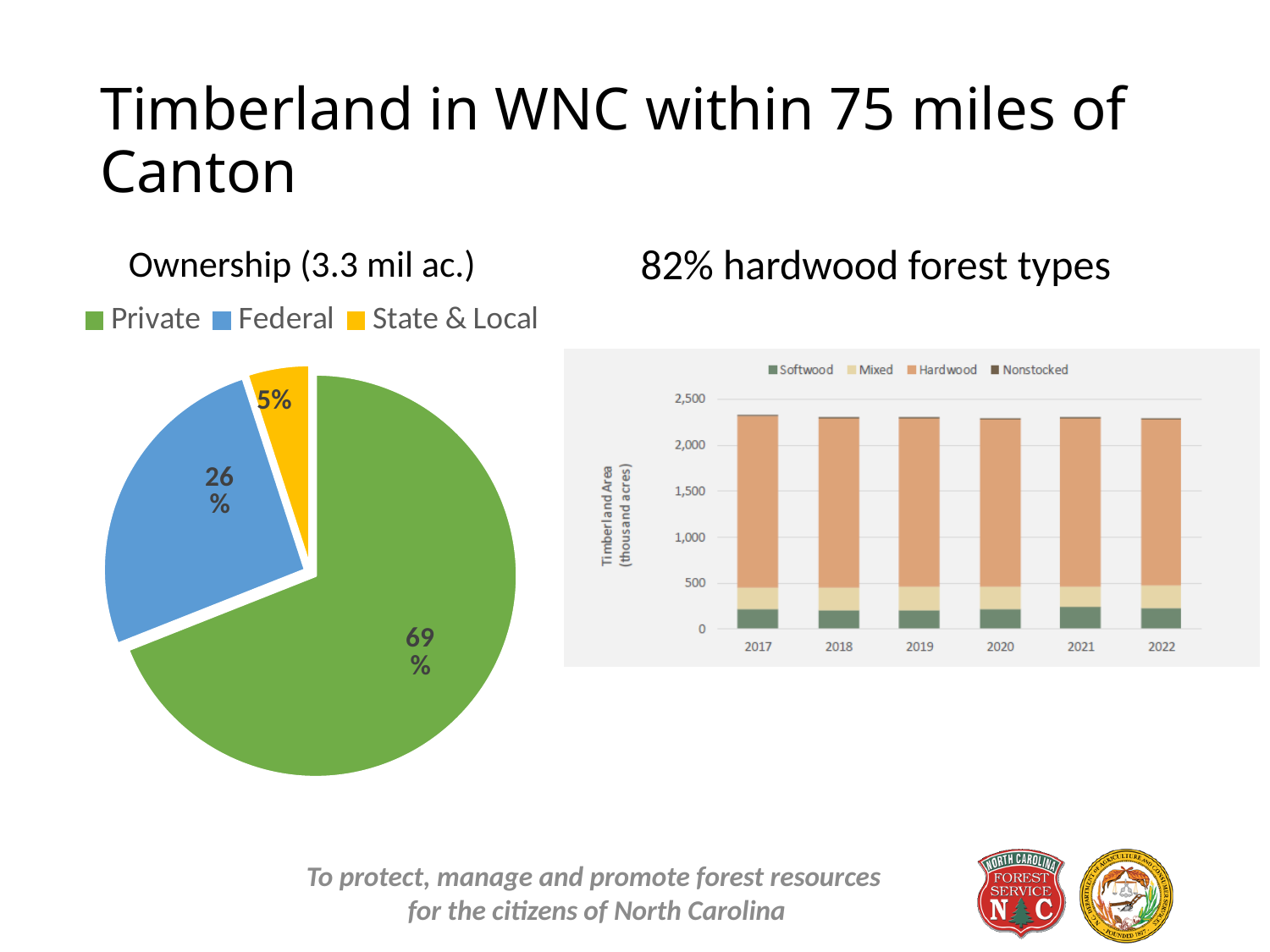
In the Ownership pie chart, which ownership category has the largest share? Private In the forest types bar chart on the right, how many years are shown on the x axis? 6 In the forest types bar chart on the right, how many series does the legend list? 4 In the Ownership pie chart, what is the difference in percentage points between the Private and Federal shares? 43 What kind of chart is the forest types chart on the right? Stacked bar chart In the Ownership pie chart, which ownership category has the smallest share? State & Local In the Ownership pie chart, what share of timberland is Federal? 26% In the Ownership pie chart, what share of timberland is Private? 69% What kind of chart is the Ownership chart on the left? Pie chart In the Ownership pie chart, what share of timberland is State & Local? 5% In the Ownership pie chart, how many ownership categories are shown? 3 In the forest types bar chart on the right, is the total timberland area for 2017 greater or less than 2,000 thousand acres? greater